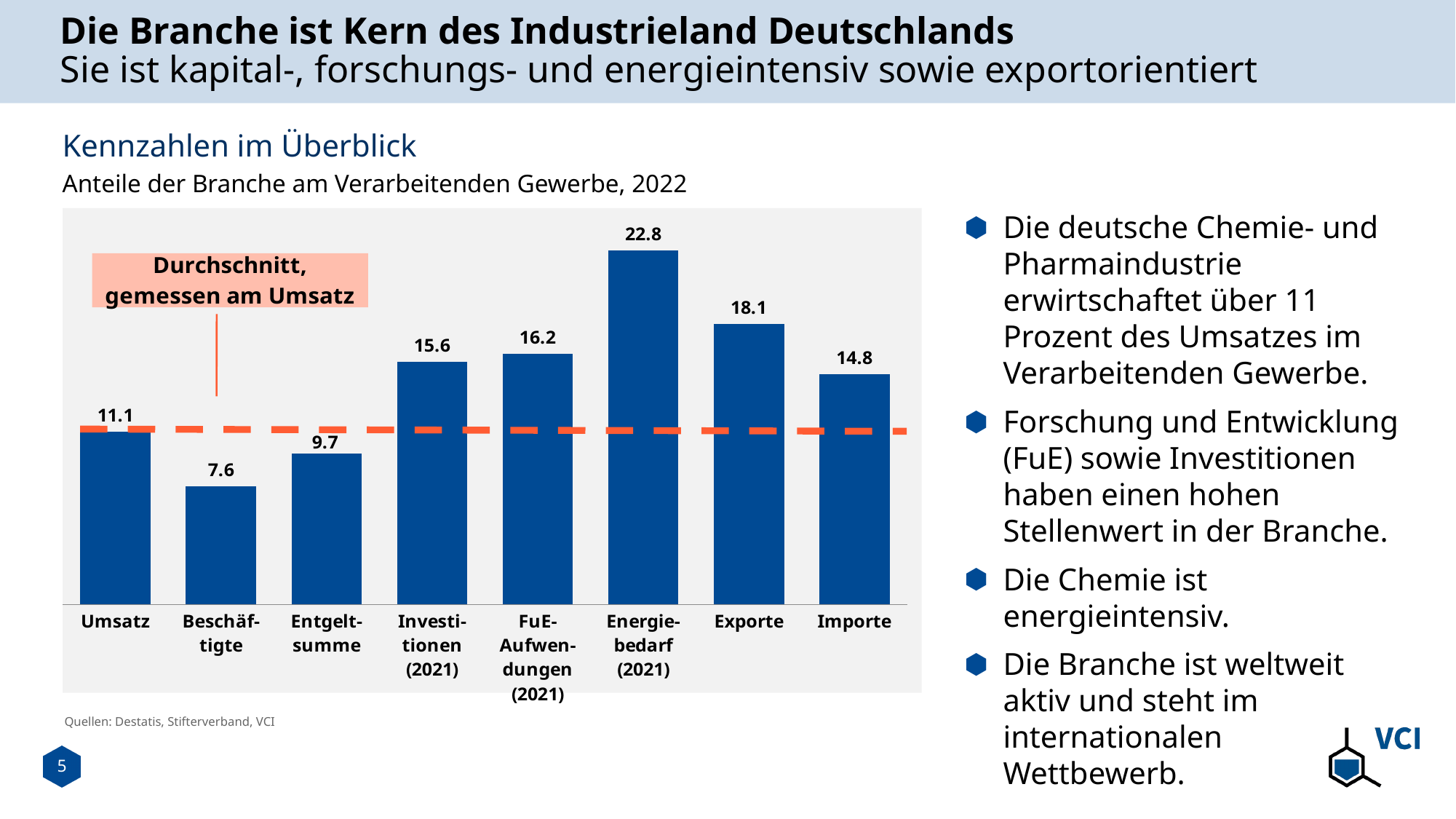
What is the subtitle of the chart below 'Kennzahlen im Überblick'? Anteile der Branche am Verarbeitenden Gewerbe, 2022 What is the value for Exporte? 18.1 What is the value for Energiebedarf (2021)? 22.8 How many categories are shown in the bar chart? 8 Which is larger, the value for Entgeltsumme or the value for Beschäftigte? Entgeltsumme Which category has the lowest value? Beschäftigte What kind of chart is shown on the slide? Bar chart What is the value for Umsatz? 11.1 What is the difference between the values for Exporte and Importe? 3.3 What is the difference between the values for FuE-Aufwendungen (2021) and Investitionen (2021)? 0.6 What does the dashed orange line in the chart represent? Durchschnitt, gemessen am Umsatz Which category has the highest value? Energiebedarf (2021)